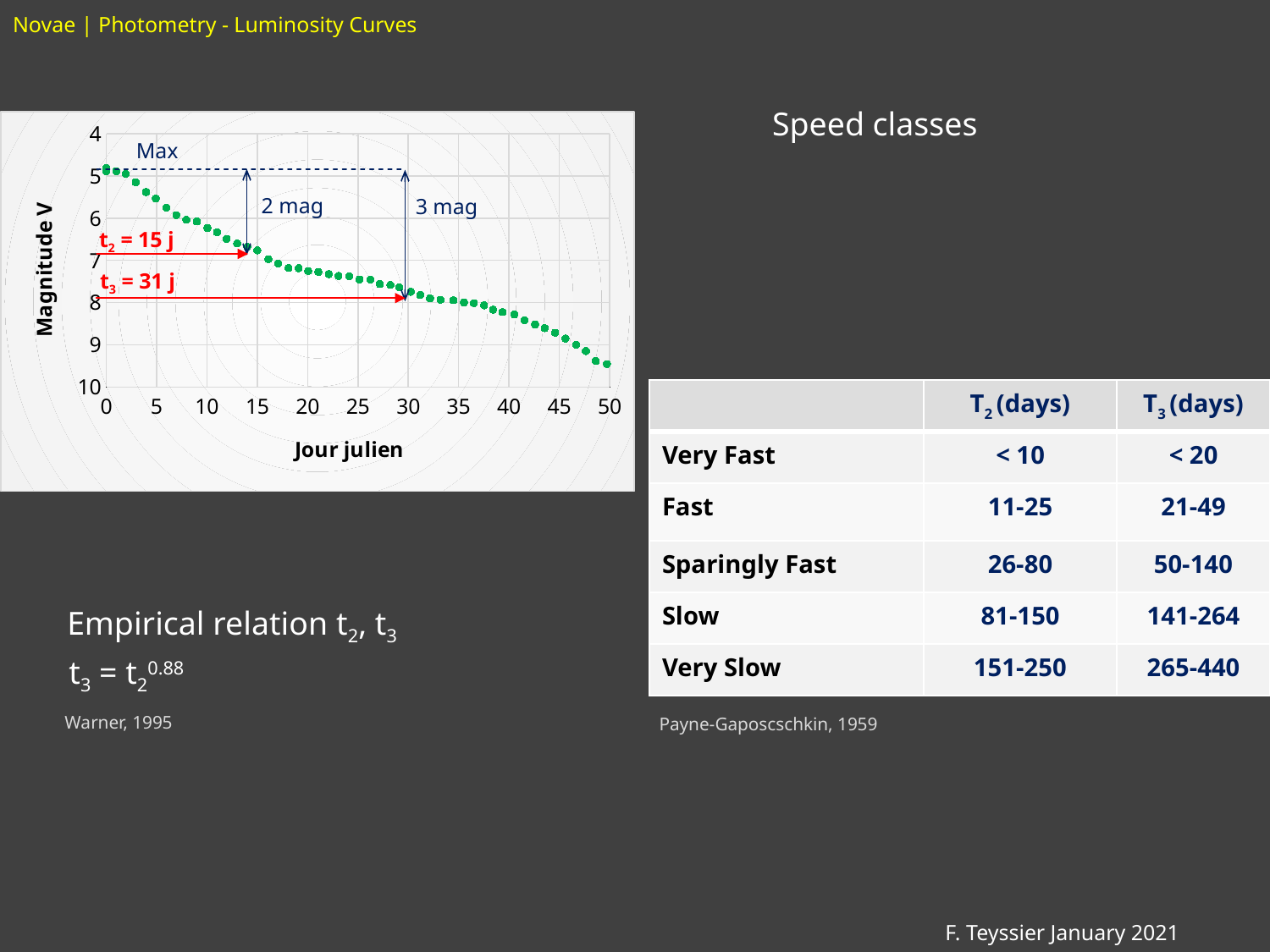
What is the label of the y axis of the chart? Magnitude V According to the annotation on the chart, what is the value of t2? 15 j How many magnitudes below maximum does the chart mark at t2? 2 mag What is the label of the x axis of the chart? Jour julien Does the plotted curve go up or down as Jour julien increases from 0 to 50? down What is the highest value shown on the x axis of the chart? 50 How many magnitudes below maximum does the chart mark at t3? 3 mag Is the magnitude V plotted at day 0 greater or less than 6? less Is the magnitude V plotted at day 50 greater or less than 9? greater What kind of chart is shown on the slide? scatter (dotted line) chart According to the annotation on the chart, what is the value of t3? 31 j Is the magnitude V value at day 50 larger or smaller than the value at day 0? larger